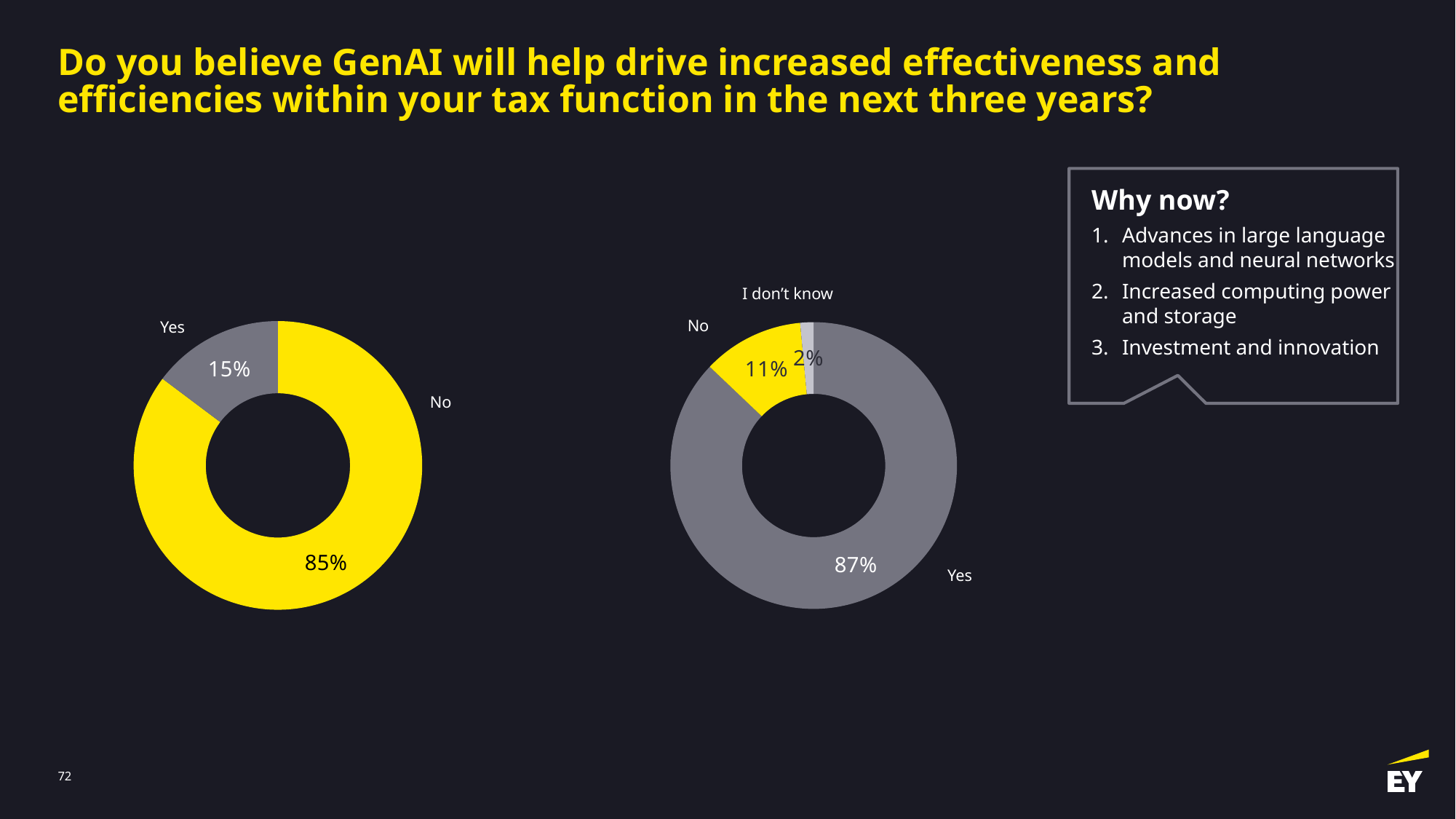
In the right donut chart, which category has the largest share? Yes In the right donut chart, which is larger, No or I don't know? No What type of chart is used on the left of the slide? Donut (pie) chart In the left donut chart, what percentage is shown for Yes? 15% In the right donut chart, what percentage is shown for No? 11% In the left donut chart, what percentage is shown for No? 85% In the left donut chart, what is the difference between the No and Yes percentages? 70% In the right donut chart, what percentage is shown for Yes? 87% In the right donut chart, what percentage is shown for I don't know? 2% In the right donut chart, how many categories are shown? 3 In the right donut chart, which category has the smallest share? I don't know In the left donut chart, which category has the largest share? No